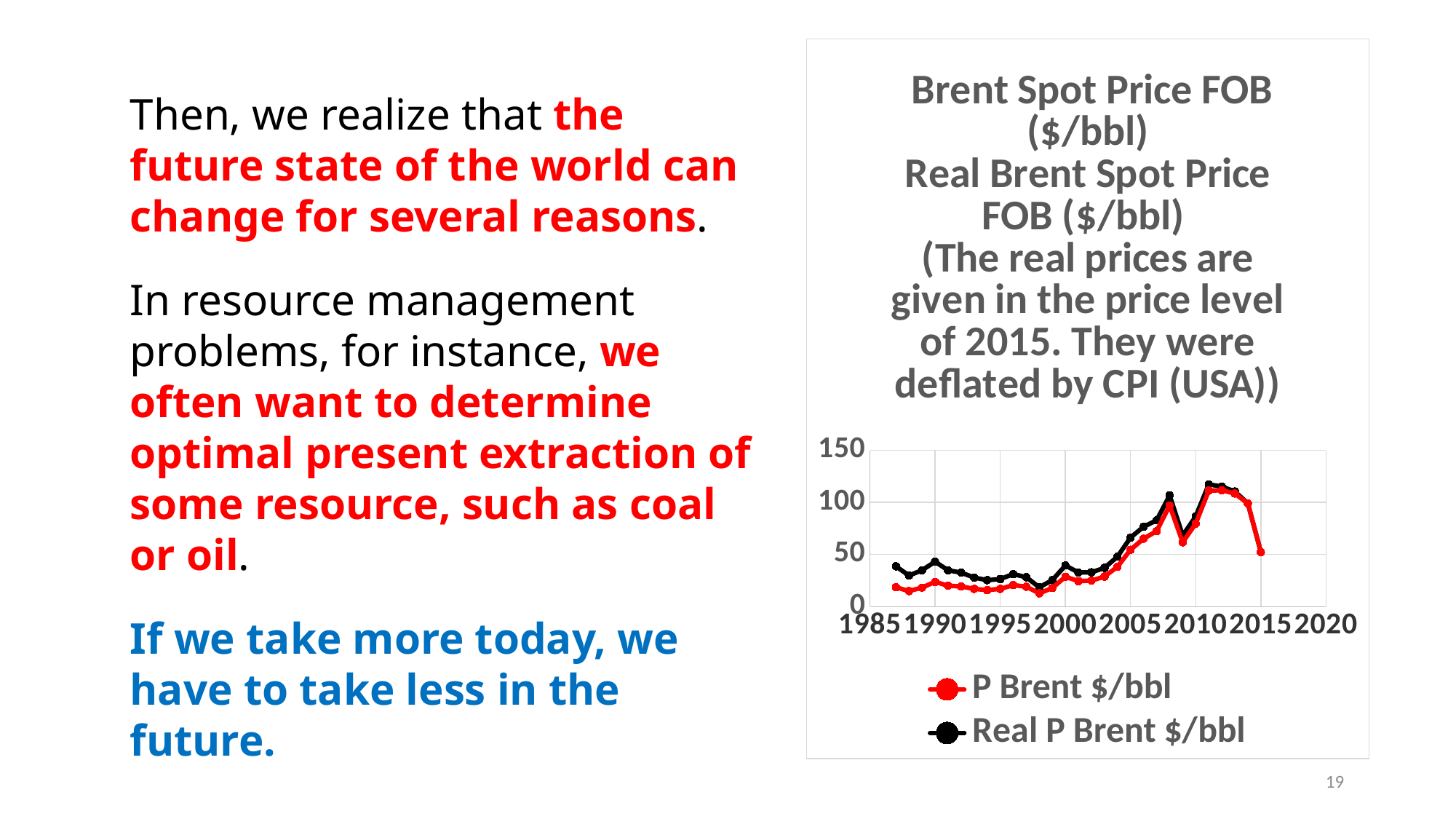
Is the value of P Brent $/bbl in 2005 greater or less than 100? less In 1995, which series has the lower value, P Brent $/bbl or Real P Brent $/bbl? P Brent $/bbl Which series is drawn in red? P Brent $/bbl How many series does the legend list? 2 Is the value of Real P Brent $/bbl in 1990 greater or less than 50? less Is the value of Real P Brent $/bbl around 2011 greater or less than 100? greater Which series is drawn in black? Real P Brent $/bbl In 2000, which series has the higher value, P Brent $/bbl or Real P Brent $/bbl? Real P Brent $/bbl Do the Real P Brent $/bbl values rise or fall between 2011 and 2015? fall What kind of chart is shown on the slide? line chart Do the P Brent $/bbl values rise or fall between 2002 and 2008? rise